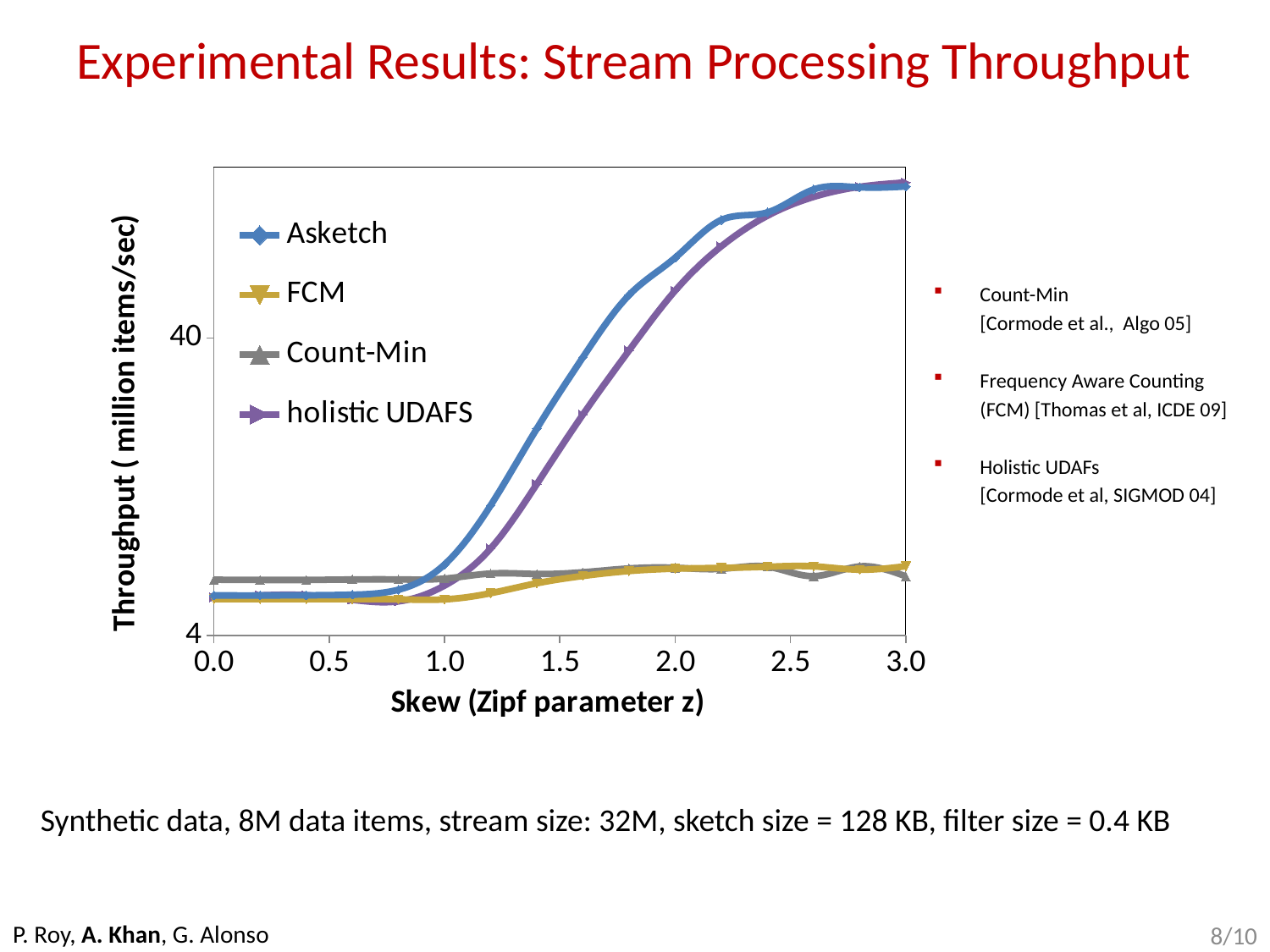
What is the label of the x axis of the chart? Skew (Zipf parameter z) Is the Asketch throughput at skew 0.0 greater or less than 40? less Is the Asketch throughput at skew 3.0 greater or less than 40? greater At skew 3.0, which series has the higher throughput, Asketch or FCM? Asketch Is the Count-Min throughput at skew 3.0 greater or less than 40? less Does the Asketch throughput rise or fall as the skew increases from 1.0 to 3.0? rise Which series are listed in the chart's legend? Asketch, FCM, Count-Min, holistic UDAFS At skew 1.5, which series has the higher throughput, Asketch or holistic UDAFS? Asketch What kind of chart is shown on the slide? line chart How many series does the chart's legend list? 4